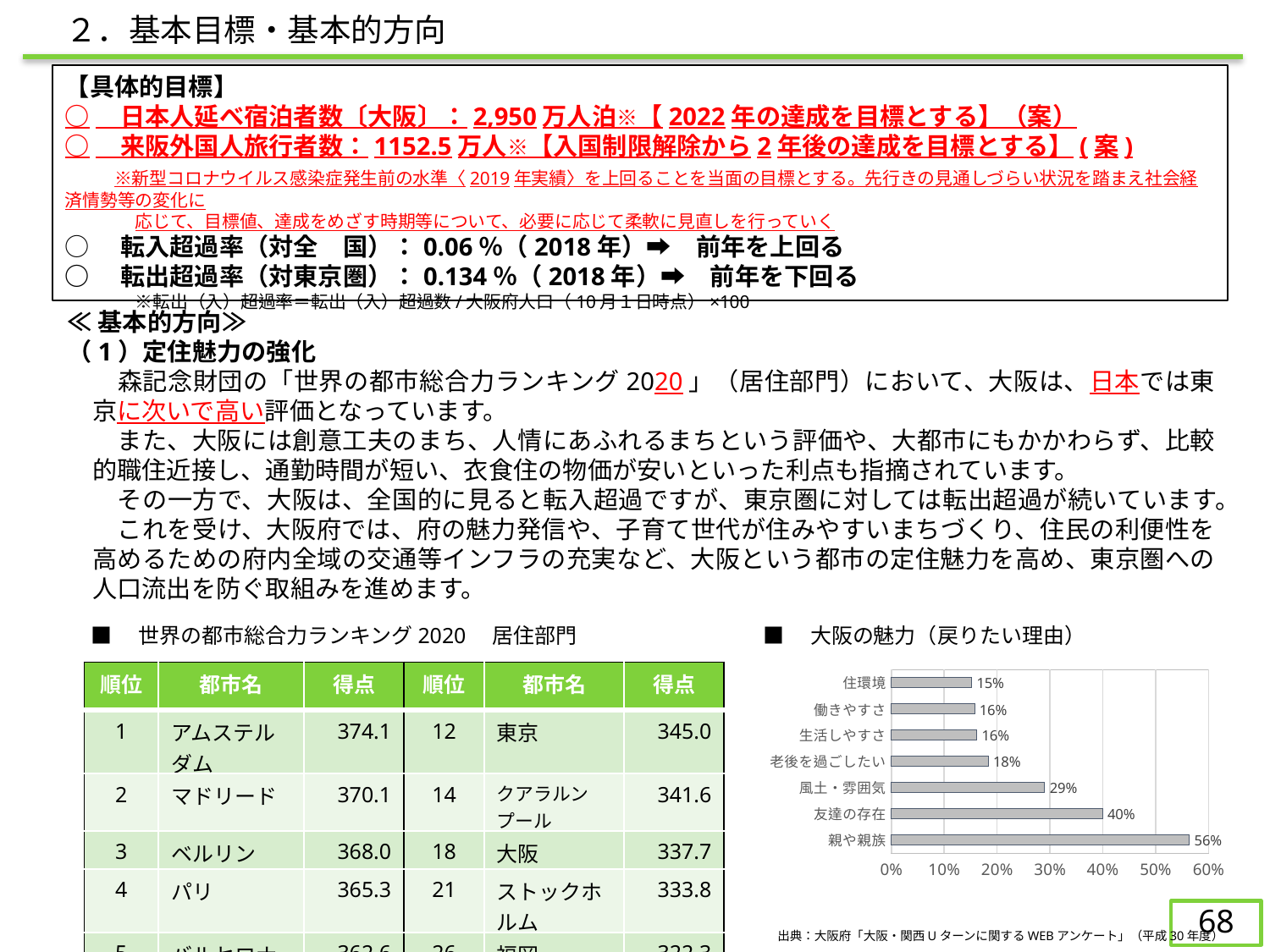
In the chart 大阪の魅力（戻りたい理由）, what is the value for 友達の存在? 40% In the chart 大阪の魅力（戻りたい理由）, is the value for 友達の存在 greater or less than 30%? greater In the chart 大阪の魅力（戻りたい理由）, what is the value for 風土・雰囲気? 29% What kind of chart is 大阪の魅力（戻りたい理由）? bar chart In the chart 大阪の魅力（戻りたい理由）, what is the difference between 親や親族 and 友達の存在? 16% In the chart 大阪の魅力（戻りたい理由）, which is larger, 風土・雰囲気 or 老後を過ごしたい? 風土・雰囲気 In the chart 大阪の魅力（戻りたい理由）, which category has the highest value? 親や親族 In the chart 大阪の魅力（戻りたい理由）, what is the highest value shown on the horizontal axis? 60% In the chart 大阪の魅力（戻りたい理由）, what is the value for 住環境? 15% In the chart 大阪の魅力（戻りたい理由）, what is the value for 親や親族? 56% In the chart 大阪の魅力（戻りたい理由）, which category has the lowest value? 住環境 How many categories are shown in the chart 大阪の魅力（戻りたい理由）? 7